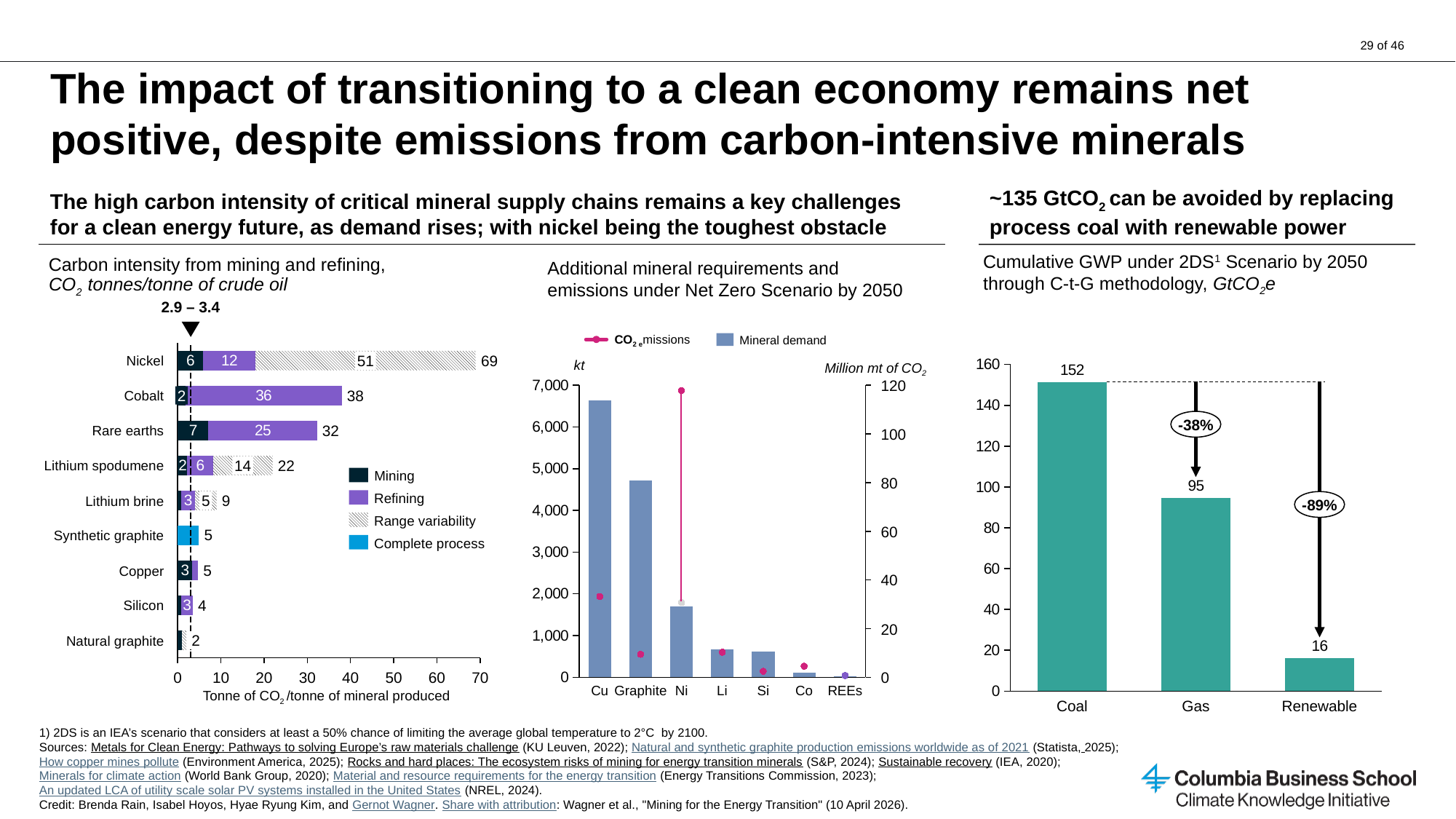
In the 'Carbon intensity from mining and refining' chart, how many minerals are listed on the vertical axis? 9 In the 'Additional mineral requirements and emissions under Net Zero Scenario by 2050' chart, is the mineral demand for Cu greater or less than 6,000 kt? greater In the 'Additional mineral requirements and emissions under Net Zero Scenario by 2050' chart, which mineral has the highest CO2e emissions? Ni In the 'Carbon intensity from mining and refining' chart, which mineral has the lowest total value? Natural graphite What kind of chart is the 'Cumulative GWP under 2DS Scenario by 2050' chart? Bar chart In the 'Carbon intensity from mining and refining' chart, what is the difference between the total values for Cobalt and Rare earths? 6 In the 'Cumulative GWP under 2DS Scenario by 2050' chart, what is the difference between the values for Coal and Renewable? 136 In the 'Carbon intensity from mining and refining' chart, what is the Refining value for Cobalt? 36 In the 'Additional mineral requirements and emissions under Net Zero Scenario by 2050' chart, how many minerals are shown on the x axis? 7 In the 'Cumulative GWP under 2DS Scenario by 2050' chart, what is the value for Gas? 95 In the 'Carbon intensity from mining and refining' chart, what is the total value shown for Nickel? 69 In the 'Carbon intensity from mining and refining' chart, how many entries does the legend list? 4